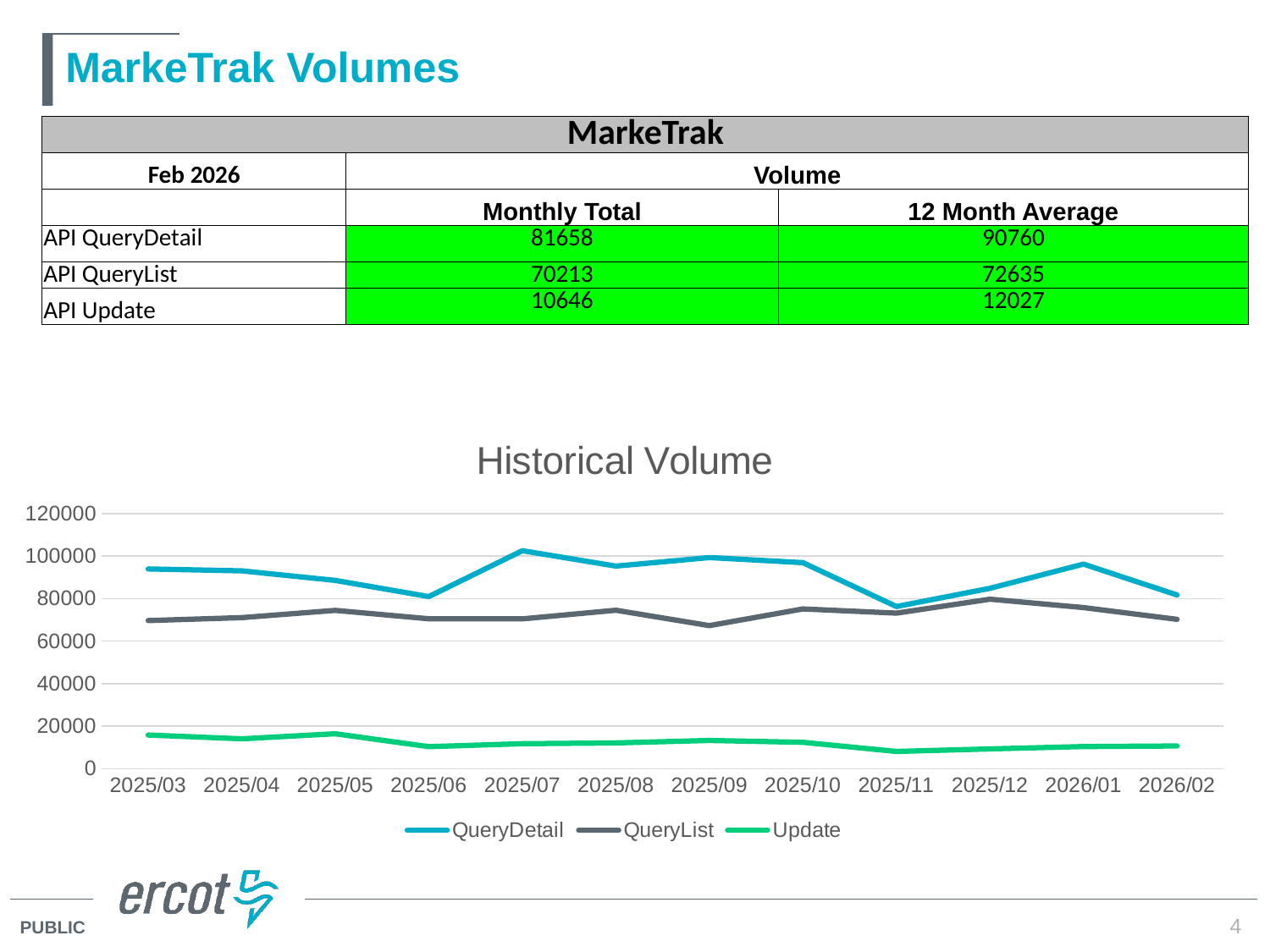
Which series are listed in the legend of the Historical Volume chart? QueryDetail, QueryList, Update Is the Update value for 2025/11 greater or less than 20000? less How many months are shown on the x axis of the Historical Volume chart? 12 Is the QueryDetail value for 2025/03 greater or less than 80000? greater At 2025/07, which series has the larger value, QueryDetail or QueryList? QueryDetail What is the title of the chart on the slide? Historical Volume Is the QueryList value for 2025/09 greater or less than 80000? less How many series does the legend of the Historical Volume chart list? 3 In which month does the QueryDetail series reach its highest value? 2025/07 Which series has the lowest values across all months in the Historical Volume chart? Update What kind of chart is the Historical Volume chart? line chart